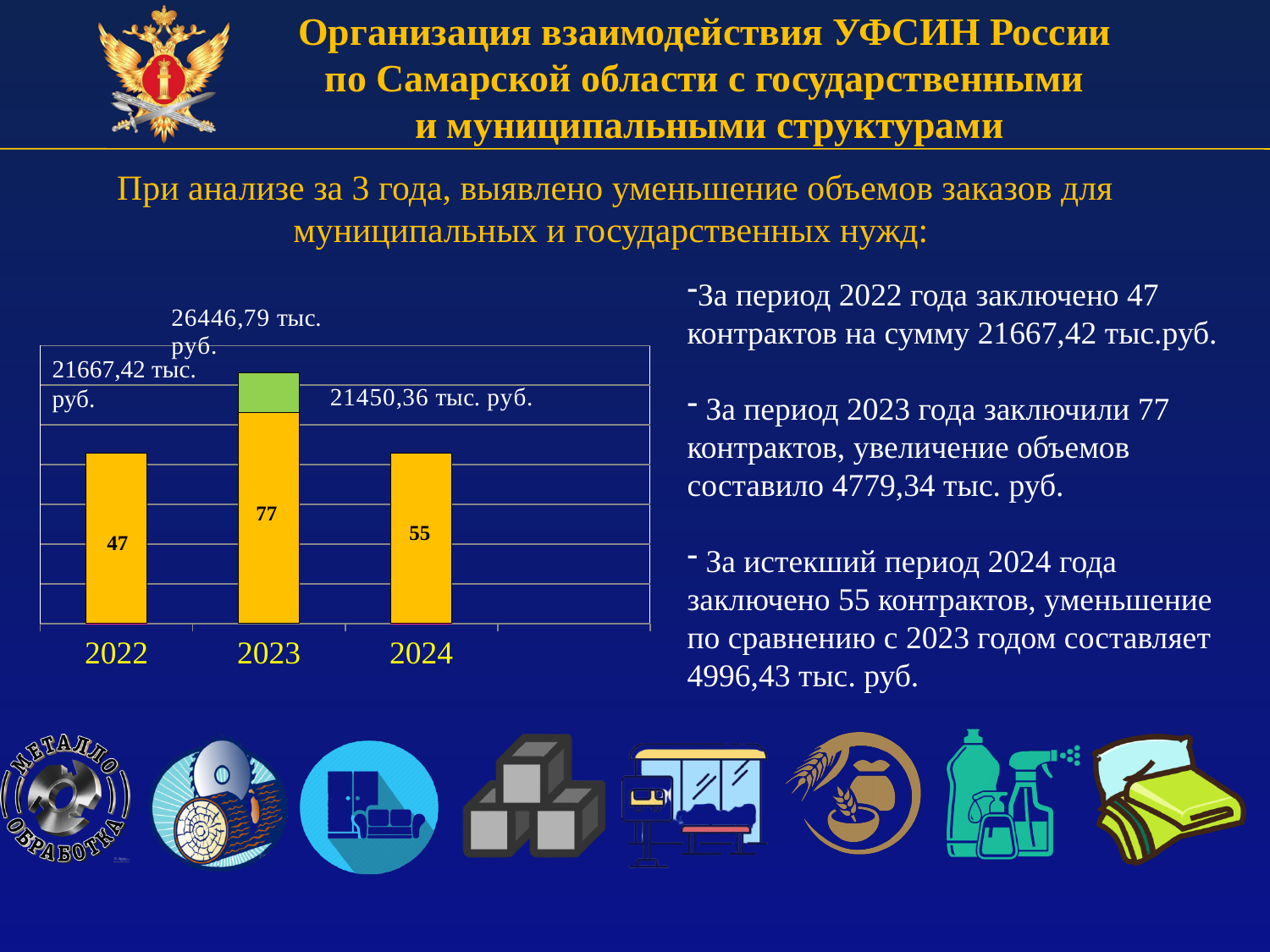
Which year has more contracts, 2024 or 2022? 2024 Which year has the highest number of contracts? 2023 What type of chart is shown on the slide? Bar chart What is the number of contracts shown on the bar for 2023? 77 How many years are shown on the x axis of the chart? 3 What is the number of contracts shown on the bar for 2024? 55 Which year has the lowest number of contracts? 2022 What sum in thousand rubles is labelled above the 2022 bar? 21667,42 тыс. руб. What is the number of contracts shown on the bar for 2022? 47 What sum in thousand rubles is labelled above the 2024 bar? 21450,36 тыс. руб. What sum in thousand rubles is labelled above the 2023 bar? 26446,79 тыс. руб. By how many contracts does 2023 exceed 2022? 30